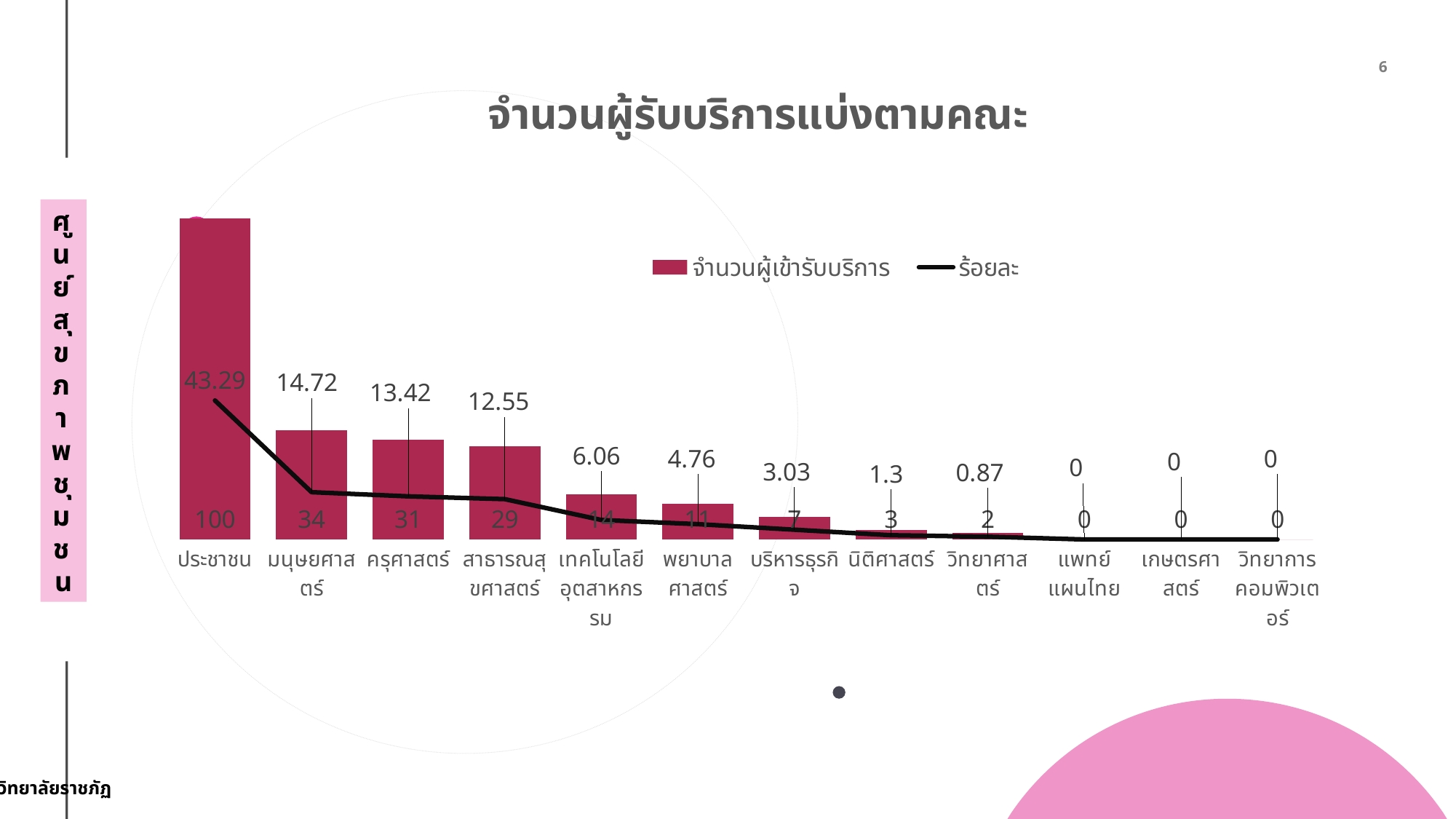
What kind of chart is this? Combined bar and line chart What is the percentage (ร้อยละ) value for มนุษยศาสตร์? 14.72 How many categories are shown on the x axis? 12 What is the number of service recipients (จำนวนผู้เข้ารับบริการ) for ประชาชน? 100 Do the number of service recipients rise or fall from left to right along the x axis? Fall How many series does the legend list? 2 What is the title of the chart? จำนวนผู้รับบริการแบ่งตามคณะ Which category has the highest number of service recipients? ประชาชน What is the difference in number of service recipients between มนุษยศาสตร์ and ครุศาสตร์? 3 What is the number of service recipients for พยาบาลศาสตร์? 11 What is the percentage (ร้อยละ) value for นิติศาสตร์? 1.3 Which has more service recipients, สาธารณสุขศาสตร์ or เทคโนโลยีอุตสาหกรรม? สาธารณสุขศาสตร์